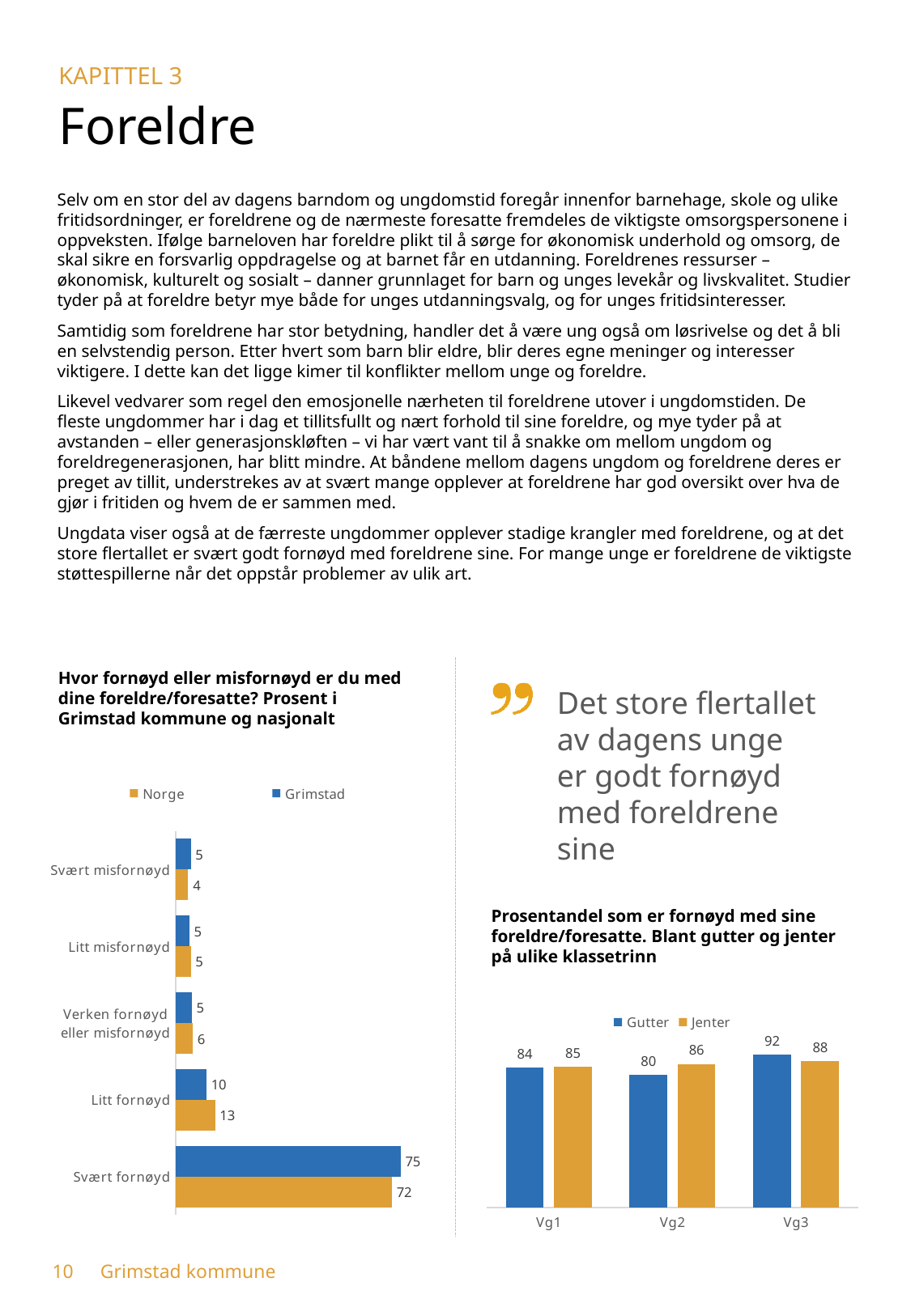
In the right chart (Prosentandel som er fornøyd med sine foreldre/foresatte), which class level has the lowest value for Gutter? Vg2 In the right chart (Prosentandel som er fornøyd med sine foreldre/foresatte), which colour represents Jenter in the legend? Orange What kind of chart is the left chart (Hvor fornøyd eller misfornøyd er du med dine foreldre/foresatte?)? Bar chart In the left chart (Hvor fornøyd eller misfornøyd er du med dine foreldre/foresatte?), what is the value for Grimstad in the Svært fornøyd category? 75 In the left chart (Hvor fornøyd eller misfornøyd er du med dine foreldre/foresatte?), which is larger in the Litt fornøyd category, Norge or Grimstad? Norge In the right chart (Prosentandel som er fornøyd med sine foreldre/foresatte), what is the value for Jenter at Vg2? 86 In the left chart (Hvor fornøyd eller misfornøyd er du med dine foreldre/foresatte?), what is the value for Norge in the Litt fornøyd category? 13 In the left chart (Hvor fornøyd eller misfornøyd er du med dine foreldre/foresatte?), how many series does the legend list? 2 In the left chart (Hvor fornøyd eller misfornøyd er du med dine foreldre/foresatte?), which category has the highest value for Norge? Svært fornøyd In the right chart (Prosentandel som er fornøyd med sine foreldre/foresatte), what is the difference between Gutter and Jenter at Vg3? 4 In the left chart (Hvor fornøyd eller misfornøyd er du med dine foreldre/foresatte?), how many categories are shown? 5 In the left chart (Hvor fornøyd eller misfornøyd er du med dine foreldre/foresatte?), what is the difference between Grimstad and Norge in the Svært fornøyd category? 3